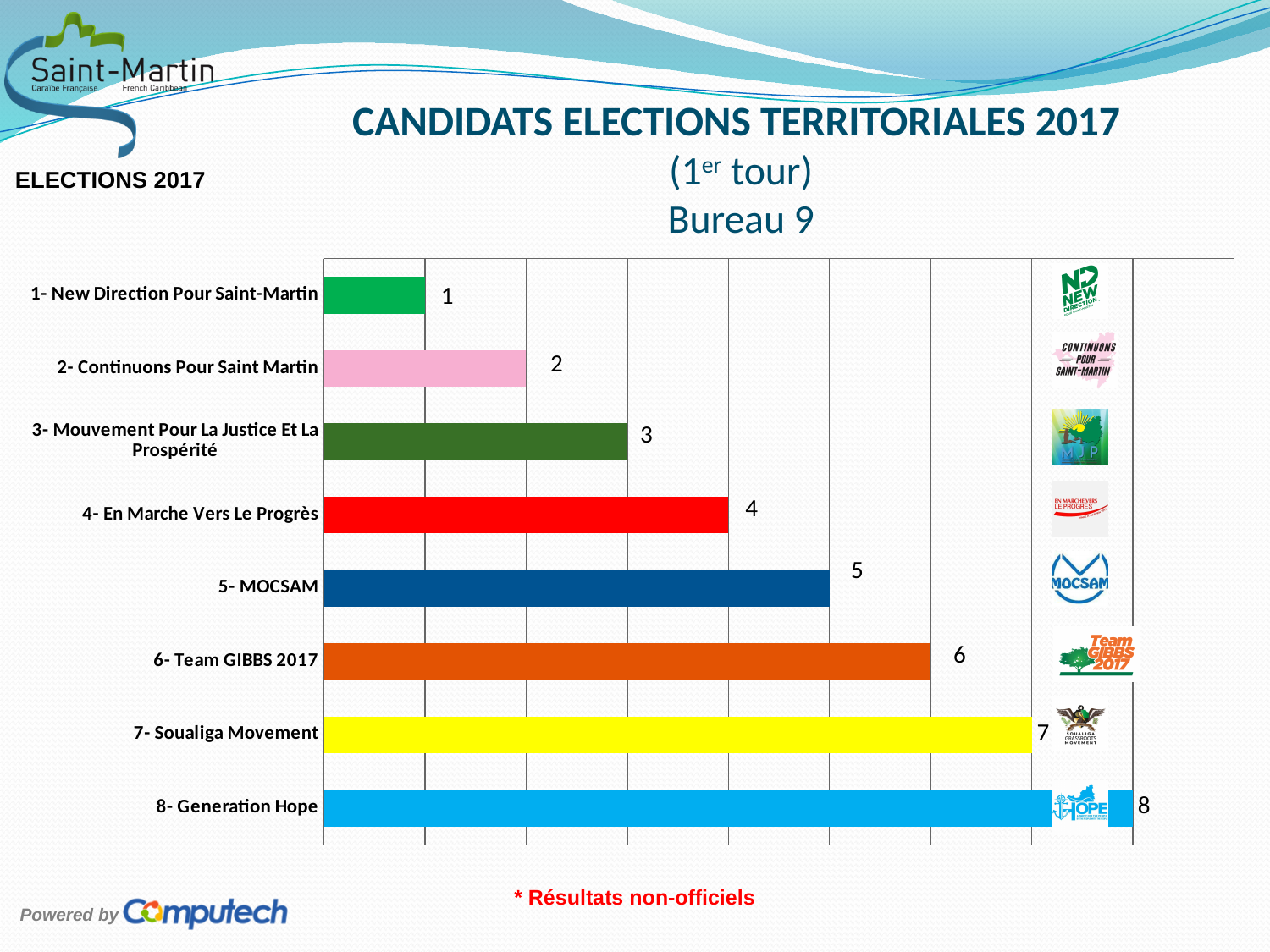
What is the value shown for 7- Soualiga Movement? 7 Which bureau does the chart title refer to? Bureau 9 How many candidate lists (categories) are plotted in the chart? 8 What colour is the bar for 4- En Marche Vers Le Progrès? red Do the bar values increase or decrease going down the list from 1- New Direction Pour Saint-Martin to 8- Generation Hope? increase Which has a larger value, 4- En Marche Vers Le Progrès or 2- Continuons Pour Saint Martin? 4- En Marche Vers Le Progrès What type of chart is shown on the slide? bar chart What is the difference between the values for 6- Team GIBBS 2017 and 3- Mouvement Pour La Justice Et La Prospérité? 3 Which category has the highest value? 8- Generation Hope Which category has the lowest value? 1- New Direction Pour Saint-Martin What is the value shown for 5- MOCSAM? 5 What is the value shown for 2- Continuons Pour Saint Martin? 2